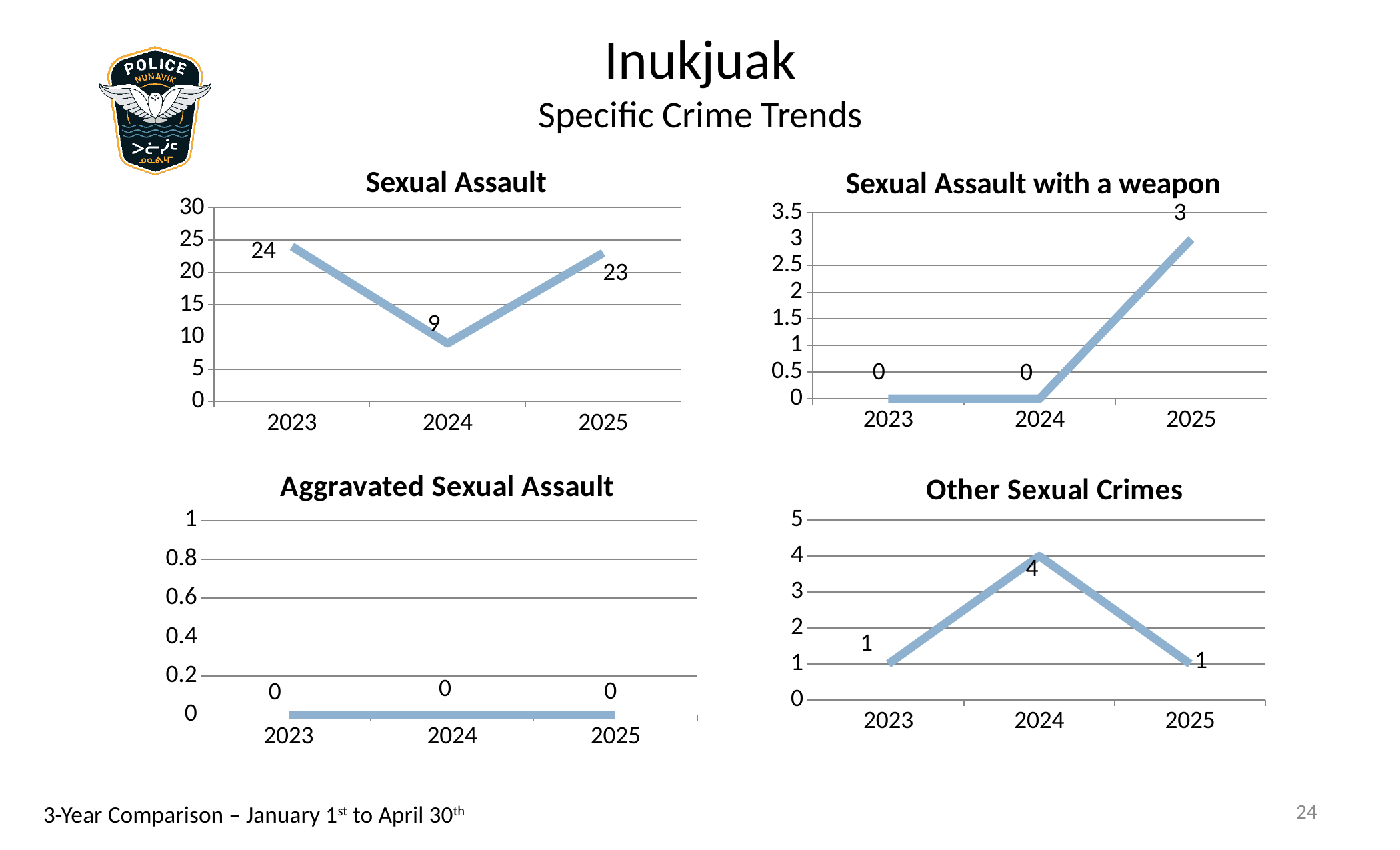
In the Other Sexual Crimes chart, is the value for 2024 larger than the value for 2023? Yes What kind of chart is the Other Sexual Crimes chart? Line chart How many years are plotted in the Sexual Assault chart? 3 In the Sexual Assault chart, which year has the highest value? 2023 In the Other Sexual Crimes chart, which year has the highest value? 2024 In the Aggravated Sexual Assault chart, what is the value for 2024? 0 In the Other Sexual Crimes chart, what is the difference between the 2024 and 2025 values? 3 In the Sexual Assault with a weapon chart, do the values rise or fall from 2024 to 2025? Rise In the Sexual Assault with a weapon chart, what is the value for 2023? 0 In the Sexual Assault chart, what is the value for 2024? 9 In the Sexual Assault chart, what is the difference between the 2023 and 2025 values? 1 In the Sexual Assault with a weapon chart, what is the value for 2025? 3